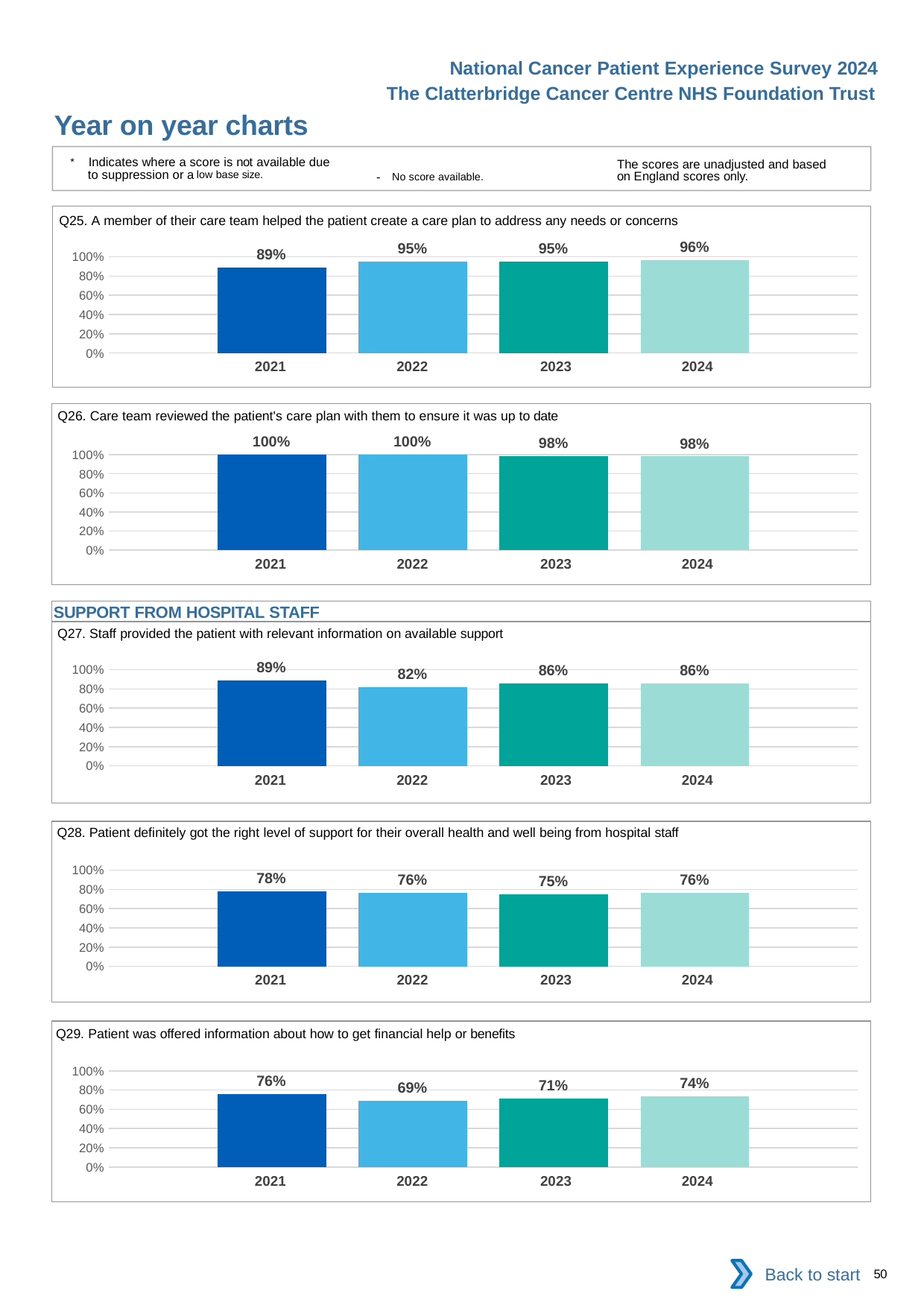
In the Q26 chart, what is the value for 2023? 98% In the Q27 chart, what is the difference between the 2021 and 2022 values? 7 percentage points What type of chart is used for Q28? Bar chart In the Q27 chart, which year has the lowest value? 2022 In the Q28 chart, is the value for 2021 greater or less than 80%? less In the Q29 chart, what is the value for 2021? 76% In the Q26 chart, what is the difference between the 2021 and 2024 values? 2 percentage points In the Q28 chart, what is the value for 2023? 75% In the Q25 chart, which year has the highest value? 2024 How many years are shown on the x axis of the Q29 chart? 4 In the Q25 chart, what is the value for 2021? 89% In the Q29 chart, which is larger, the value for 2022 or the value for 2024? 2024